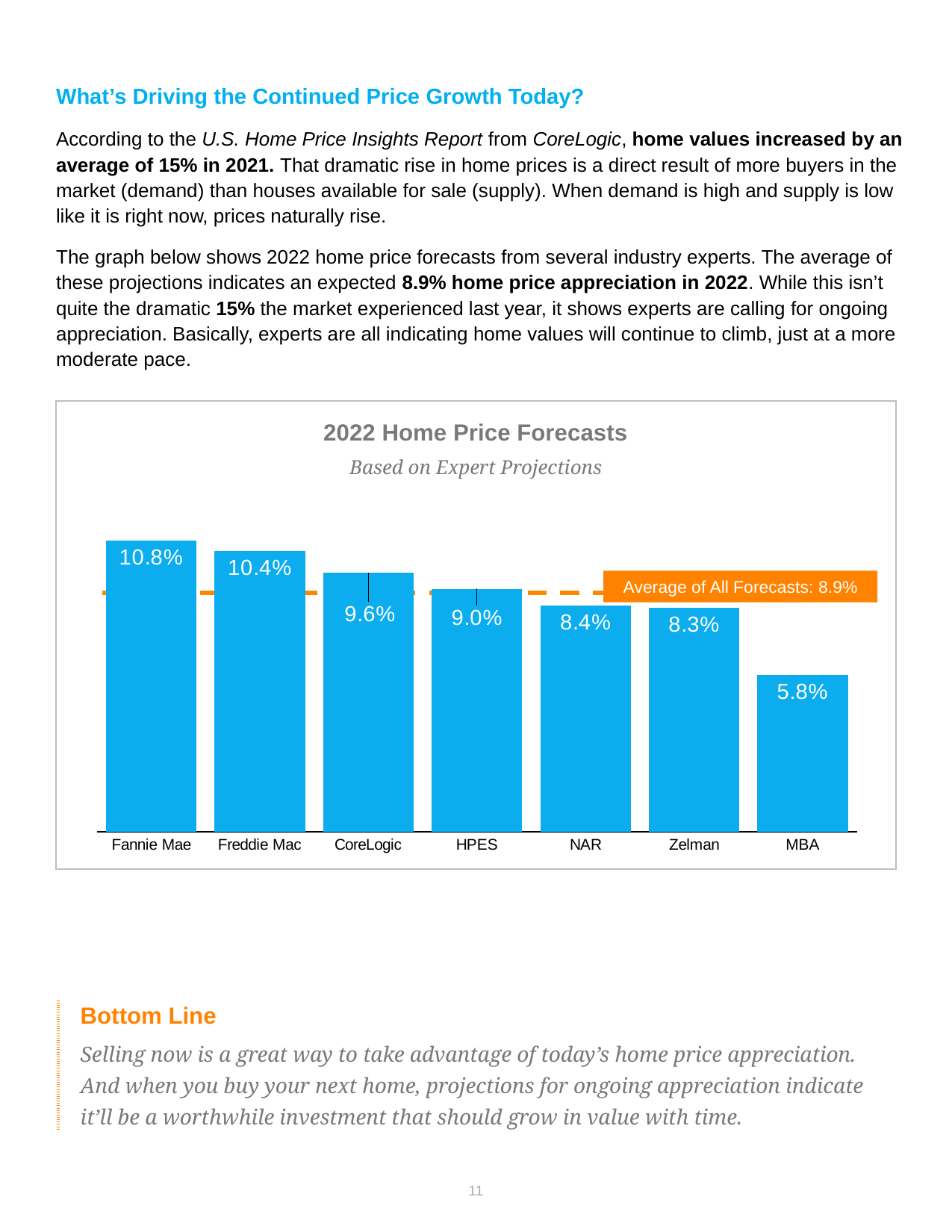
What is the difference between the Fannie Mae and MBA forecasts? 5.0% What is the 2022 home price forecast from MBA? 5.8% How many forecasters are shown in the chart? 7 What is the 2022 home price forecast from CoreLogic? 9.6% Do the forecast values rise or fall from left to right across the chart? Fall What is the difference between the Freddie Mac and HPES forecasts? 1.4% What value does the dashed orange line labeled 'Average of All Forecasts' represent? 8.9% What is the 2022 home price forecast from Fannie Mae? 10.8% What kind of chart is shown on the slide? Bar chart Which forecaster has the lowest 2022 home price forecast? MBA Which is larger, the NAR forecast or the Zelman forecast? NAR Which forecaster has the highest 2022 home price forecast? Fannie Mae